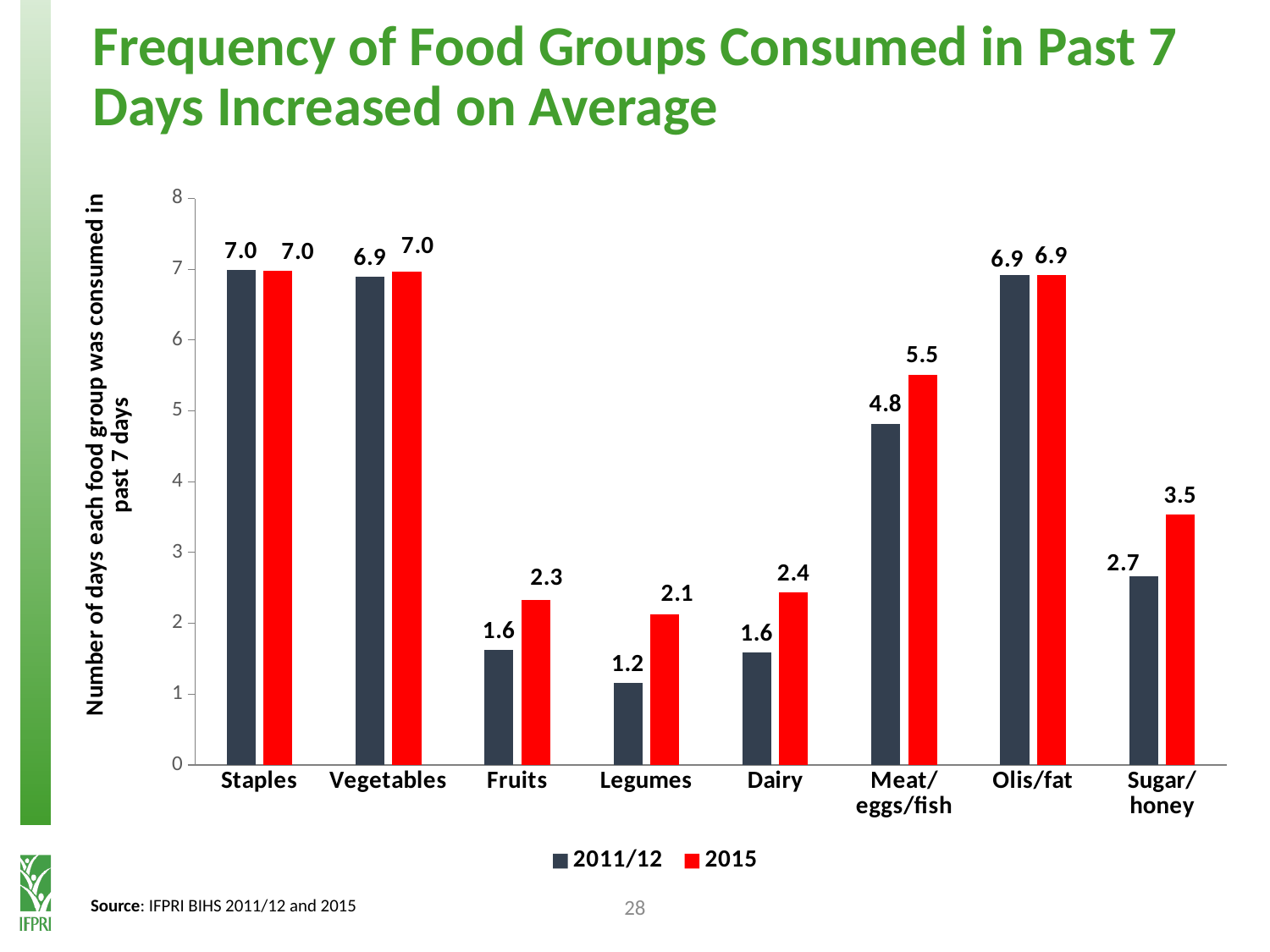
Which is larger: the 2015 value for Fruits or the 2015 value for Legumes? Fruits What type of chart is shown on the slide? Bar chart How many food groups are shown on the x axis? 8 How many series does the legend list? 2 Which food group has the lowest value in 2011/12? Legumes What is the value for Meat/eggs/fish in 2015? 5.5 Is the 2011/12 value for Meat/eggs/fish greater or less than 4? greater What is the difference between the 2015 and 2011/12 values for Dairy? 0.8 What is the difference between the 2015 and 2011/12 values for Sugar/honey? 0.8 What is the value for Sugar/honey in 2011/12? 2.7 Which food group has the lowest value in 2015? Legumes What is the value for Legumes in 2011/12? 1.2